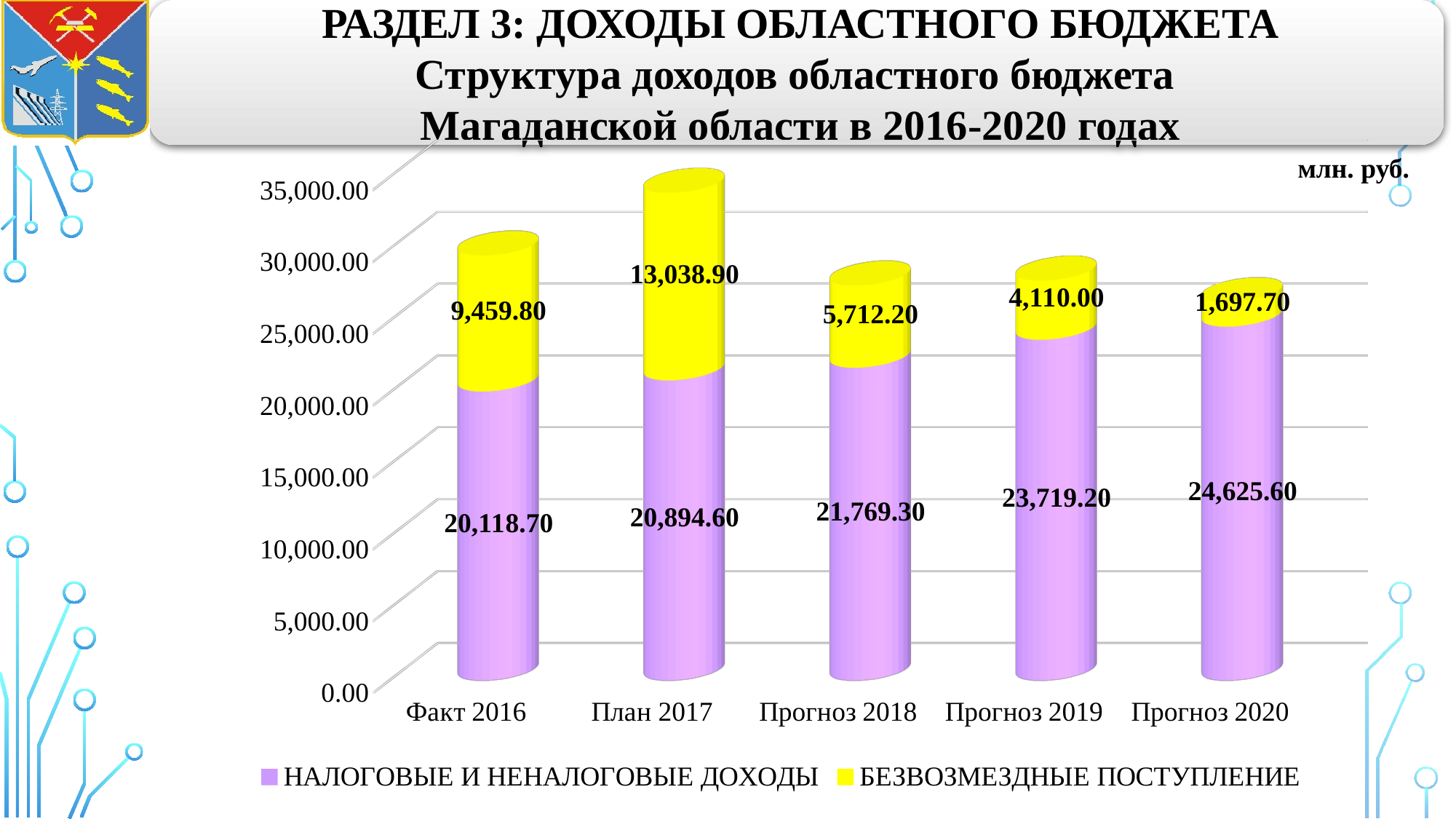
What is the value of НАЛОГОВЫЕ И НЕНАЛОГОВЫЕ ДОХОДЫ for Факт 2016? 20,118.70 Which category has the lowest value for НАЛОГОВЫЕ И НЕНАЛОГОВЫЕ ДОХОДЫ? Факт 2016 Does the value of НАЛОГОВЫЕ И НЕНАЛОГОВЫЕ ДОХОДЫ rise or fall from Факт 2016 to Прогноз 2020? rise Which is larger: БЕЗВОЗМЕЗДНЫЕ ПОСТУПЛЕНИЕ for Прогноз 2018 or for Прогноз 2019? Прогноз 2018 What is the total of the stacked bar for Прогноз 2020? 26,323.30 What is the value of НАЛОГОВЫЕ И НЕНАЛОГОВЫЕ ДОХОДЫ for Прогноз 2019? 23,719.20 What is the value of БЕЗВОЗМЕЗДНЫЕ ПОСТУПЛЕНИЕ for План 2017? 13,038.90 How many categories are shown on the x axis? 5 What is the difference between НАЛОГОВЫЕ И НЕНАЛОГОВЫЕ ДОХОДЫ for Прогноз 2020 and for Факт 2016? 4,506.90 How many series does the legend list? 2 What is the total of the stacked bar for План 2017? 33,933.50 Which category has the highest value for БЕЗВОЗМЕЗДНЫЕ ПОСТУПЛЕНИЕ? План 2017